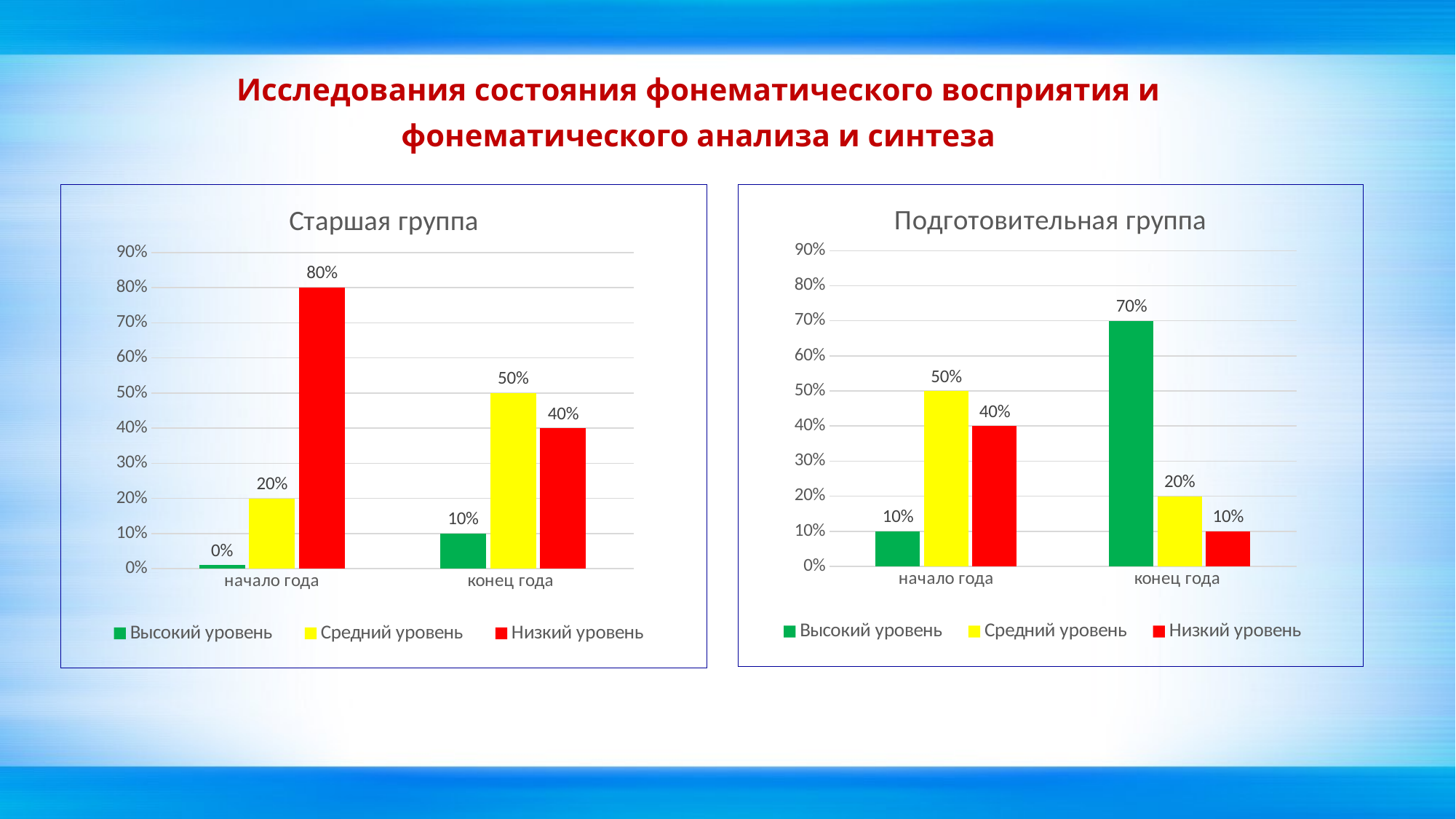
In the 'Старшая группа' chart, which series has the highest value at 'начало года'? Низкий уровень In the 'Старшая группа' chart, what is the difference between 'Низкий уровень' at 'начало года' and at 'конец года'? 40% In the 'Подготовительная группа' chart, what is the value for 'Низкий уровень' at 'начало года'? 40% How many series does the legend of the 'Подготовительная группа' chart list? 3 What kind of chart is the 'Старшая группа' chart? Bar chart In the 'Старшая группа' chart, what is the value for 'Средний уровень' at 'конец года'? 50% In the 'Старшая группа' chart, what is the value for 'Низкий уровень' at 'начало года'? 80% In the 'Подготовительная группа' chart, does the value for 'Низкий уровень' rise or fall from 'начало года' to 'конец года'? Fall In the 'Подготовительная группа' chart, what is the difference between 'Высокий уровень' at 'конец года' and at 'начало года'? 60% In the 'Старшая группа' chart, which is larger at 'конец года': 'Средний уровень' or 'Низкий уровень'? Средний уровень In the 'Подготовительная группа' chart, which series has the lowest value at 'конец года'? Низкий уровень In the 'Подготовительная группа' chart, what is the value for 'Высокий уровень' at 'конец года'? 70%